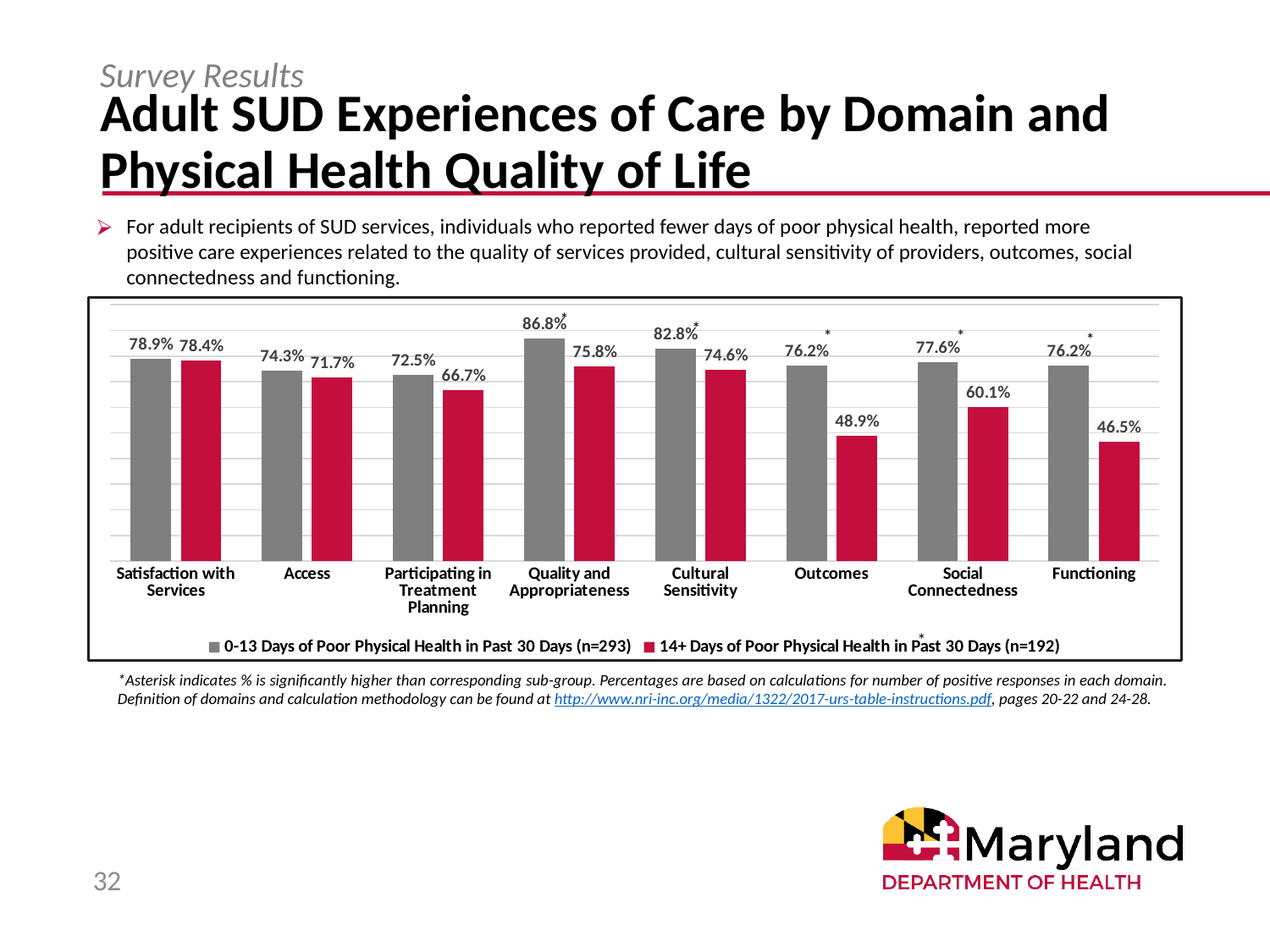
Which domain has the lowest value in the 14+ Days of Poor Physical Health in Past 30 Days (n=192) series? Functioning How many series does the legend list? 2 How many domains are shown on the x axis of the chart? 8 Which domain has the highest value in the 0-13 Days of Poor Physical Health in Past 30 Days (n=293) series? Quality and Appropriateness What is the difference between the two series for Outcomes? 27.3% What is the difference between the two series for Functioning? 29.7% What is the value for Functioning in the 14+ Days of Poor Physical Health in Past 30 Days (n=192) series? 46.5% What is the value for Quality and Appropriateness in the 0-13 Days of Poor Physical Health in Past 30 Days (n=293) series? 86.8% What kind of chart is shown on the slide? Bar chart What is the value for Outcomes in the 14+ Days of Poor Physical Health in Past 30 Days (n=192) series? 48.9% For Social Connectedness, which series has the larger value? 0-13 Days of Poor Physical Health in Past 30 Days (n=293) What colour are the bars for the 14+ Days of Poor Physical Health in Past 30 Days (n=192) series? Red